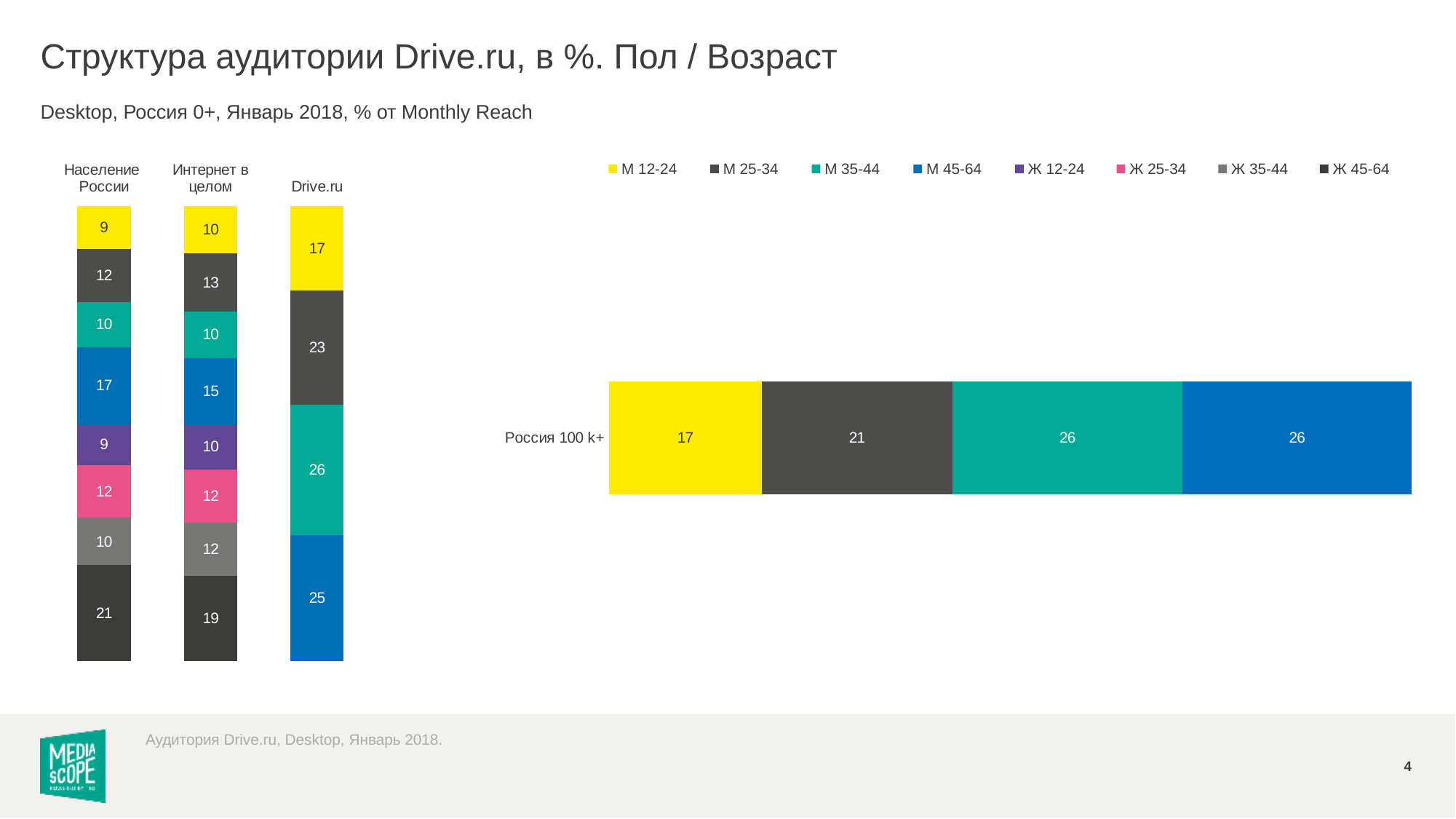
What kind of chart is the chart labelled Россия 100 k+? Stacked bar chart How many bars (categories) are shown in the left stacked bar chart? 3 In the right chart labelled Россия 100 k+, what is the total of all segments in the bar? 90 In the left stacked bar chart, which segment of the Drive.ru bar is the largest? М 35-44 In the left stacked bar chart, what is the difference between the М 25-34 values for Drive.ru and Население России? 11 In the left stacked bar chart, which is larger: the Ж 45-64 value for Население России or for Интернет в целом? Население России In the right chart labelled Россия 100 k+, what is the value of the М 35-44 segment? 26 In the left stacked bar chart, what is the value of the М 45-64 segment for Интернет в целом? 15 In the left stacked bar chart, what is the total of the Drive.ru bar? 91 In the left stacked bar chart, what is the value of the Ж 45-64 segment for Население России? 21 How many series does the legend at the top right list? 8 In the left stacked bar chart, what is the value of the М 25-34 segment for Drive.ru? 23